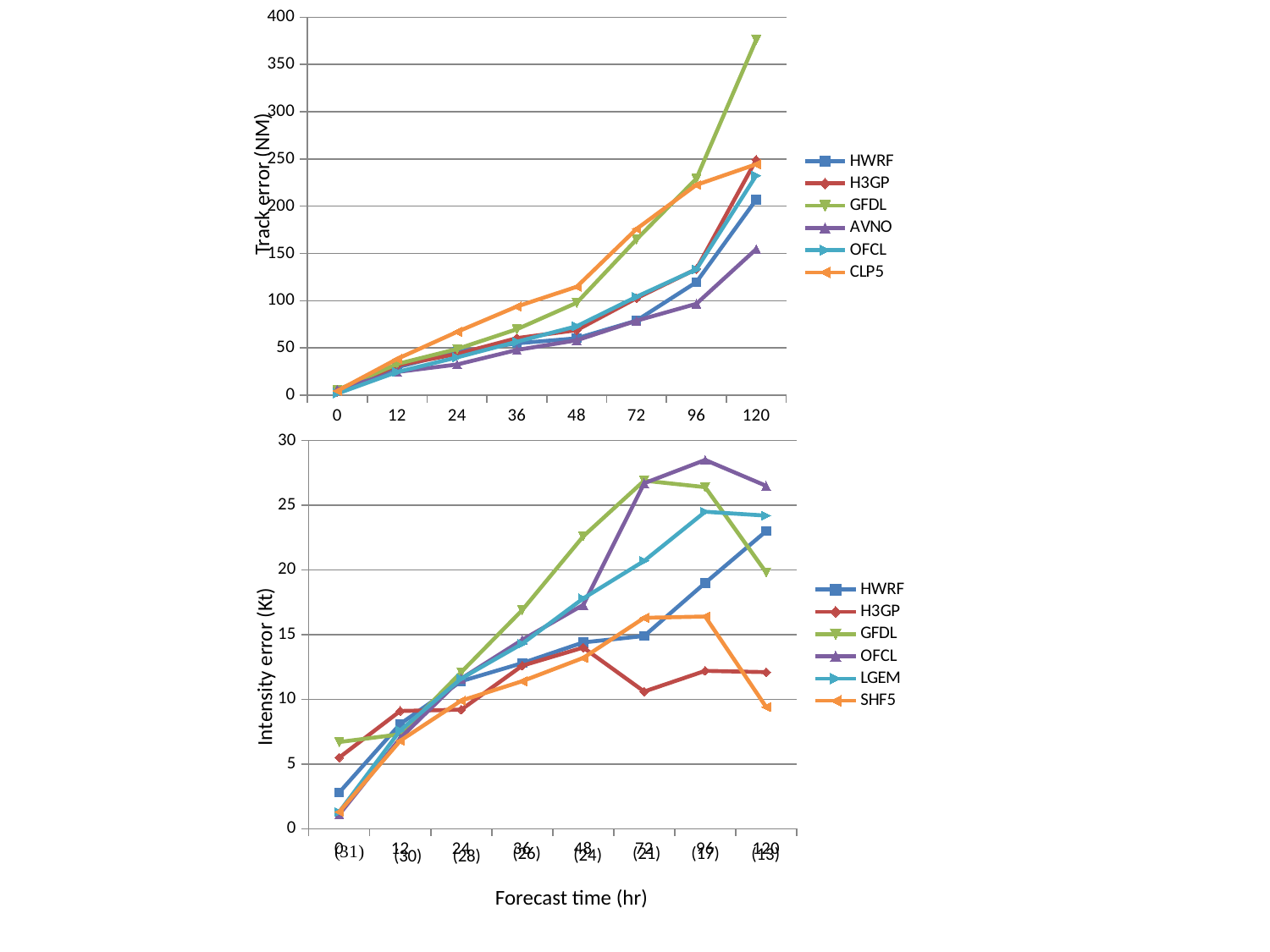
In the bottom chart (Intensity error), is the value for OFCL at 96 hr greater or less than 25? greater In the bottom chart (Intensity error), which series has the lowest value at 120 hr? SHF5 In the top chart (Track error), which series has the highest value at 120 hr? GFDL How many series does the legend of the top chart (Track error) list? 6 In the top chart (Track error), is the value for CLP5 at 48 hr greater or less than 100? greater In the top chart (Track error), is the value for GFDL at 120 hr greater or less than 350? greater How many series does the legend of the bottom chart (Intensity error) list? 6 In the top chart (Track error), which series has the lowest value at 120 hr? AVNO How many forecast time points are plotted along the x axis of the top chart (Track error)? 8 What kind of chart is the top chart (Track error)? line chart In the bottom chart (Intensity error), which series has the highest value at 96 hr? OFCL In the top chart (Track error), which is larger at 120 hr, H3GP or HWRF? H3GP